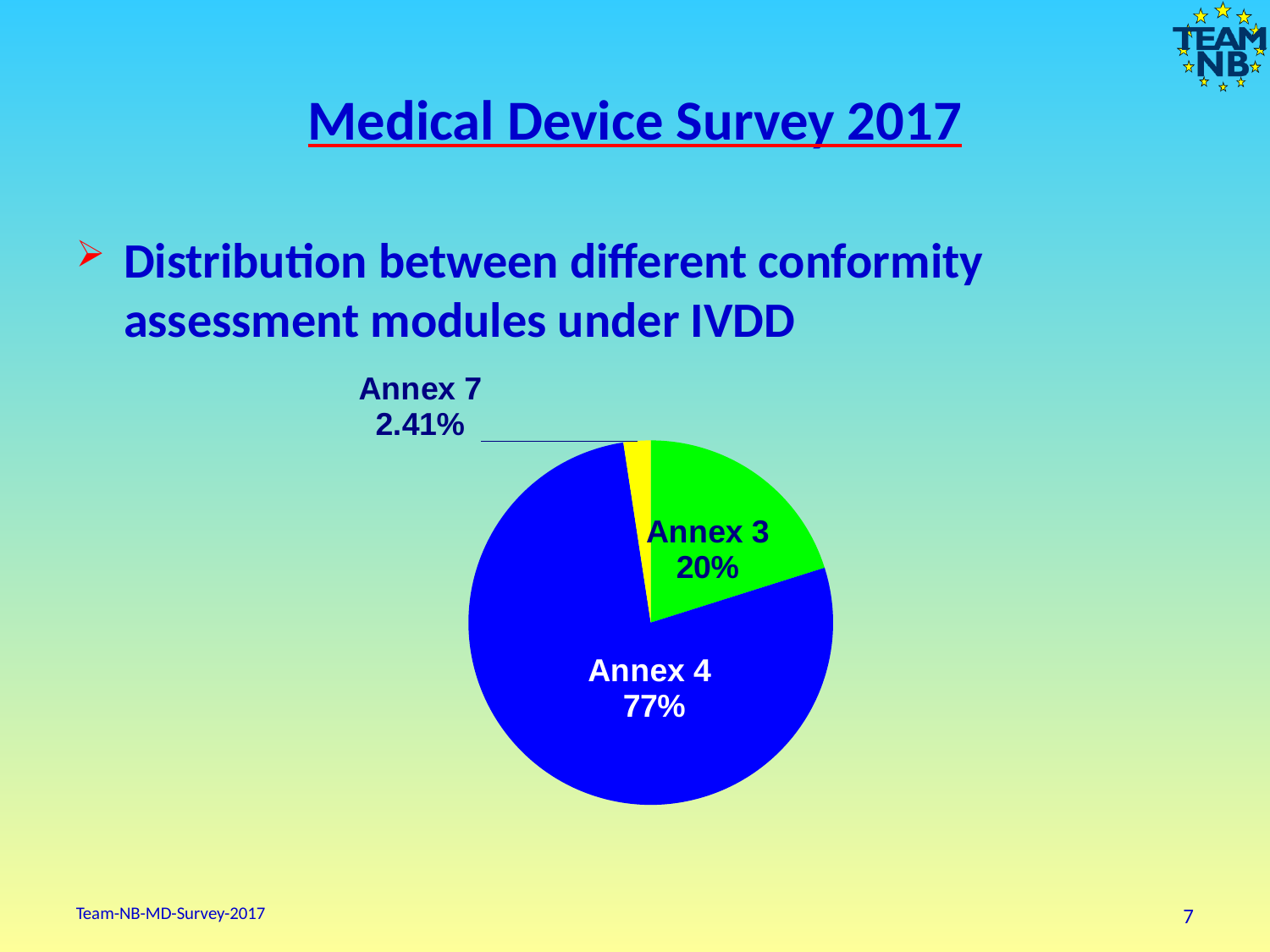
Which is larger, the share for Annex 3 or the share for Annex 7? Annex 3 What colour is the Annex 4 slice? Blue What kind of chart is shown on the slide? Pie chart How many slices does the pie chart have? 3 What share of the pie does Annex 4 represent? 77% What share of the pie does Annex 7 represent? 2.41% What is the difference in percentage points between the Annex 4 share and the Annex 3 share? 57 What colour is the Annex 7 slice? Yellow What share of the pie does Annex 3 represent? 20% Which annex has the smallest share of the pie? Annex 7 Which annex has the largest share of the pie? Annex 4